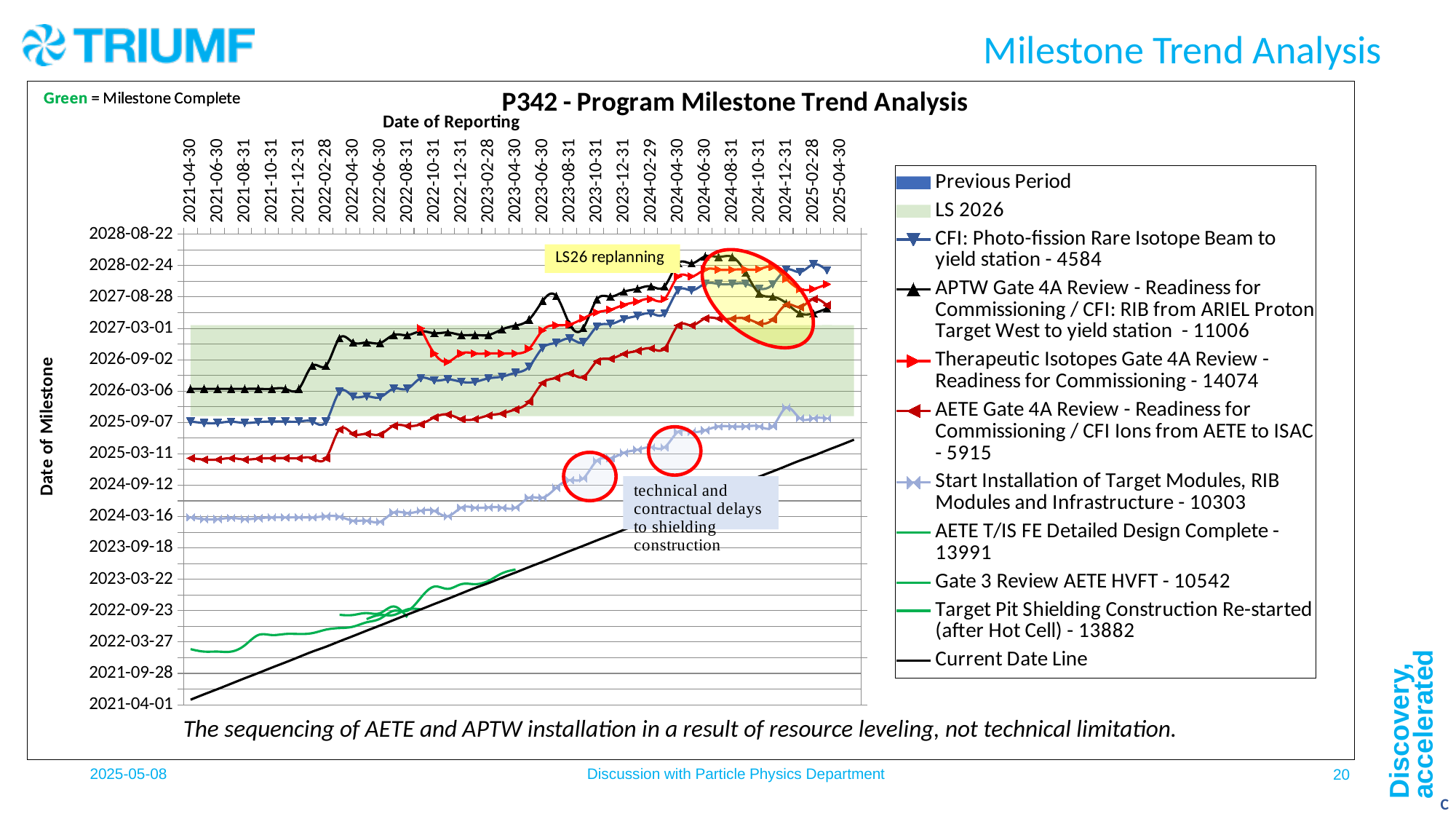
What is the title of the chart? P342 - Program Milestone Trend Analysis How many reporting dates are labelled along the x axis? 25 At the final reporting date 2025-04-30, which series has the latest milestone date? CFI: Photo-fission Rare Isotope Beam to yield station - 4584 Does the 'Start Installation of Target Modules, RIB Modules and Infrastructure - 10303' line generally rise or fall along the x axis? Rise At the reporting date 2021-04-30, is the milestone date for 'Start Installation of Target Modules, RIB Modules and Infrastructure - 10303' later or earlier than 2025-03-11? earlier At the reporting date 2025-04-30, is the milestone date for 'Therapeutic Isotopes Gate 4A Review - Readiness for Commissioning - 14074' later or earlier than 2027-03-01? later At the reporting date 2021-04-30, which series has the later milestone date: 'APTW Gate 4A Review' or 'CFI: Photo-fission Rare Isotope Beam to yield station - 4584'? APTW Gate 4A Review What type of chart is shown on the slide? Line chart How many entries does the chart legend list? 11 At the final reporting date 2025-04-30, which series has the earliest milestone date? Start Installation of Target Modules, RIB Modules and Infrastructure - 10303 According to the note on the slide, what does the colour green indicate? Milestone Complete At the reporting date 2021-04-30, which series has the later milestone date: 'AETE Gate 4A Review' or 'Start Installation of Target Modules, RIB Modules and Infrastructure - 10303'? AETE Gate 4A Review